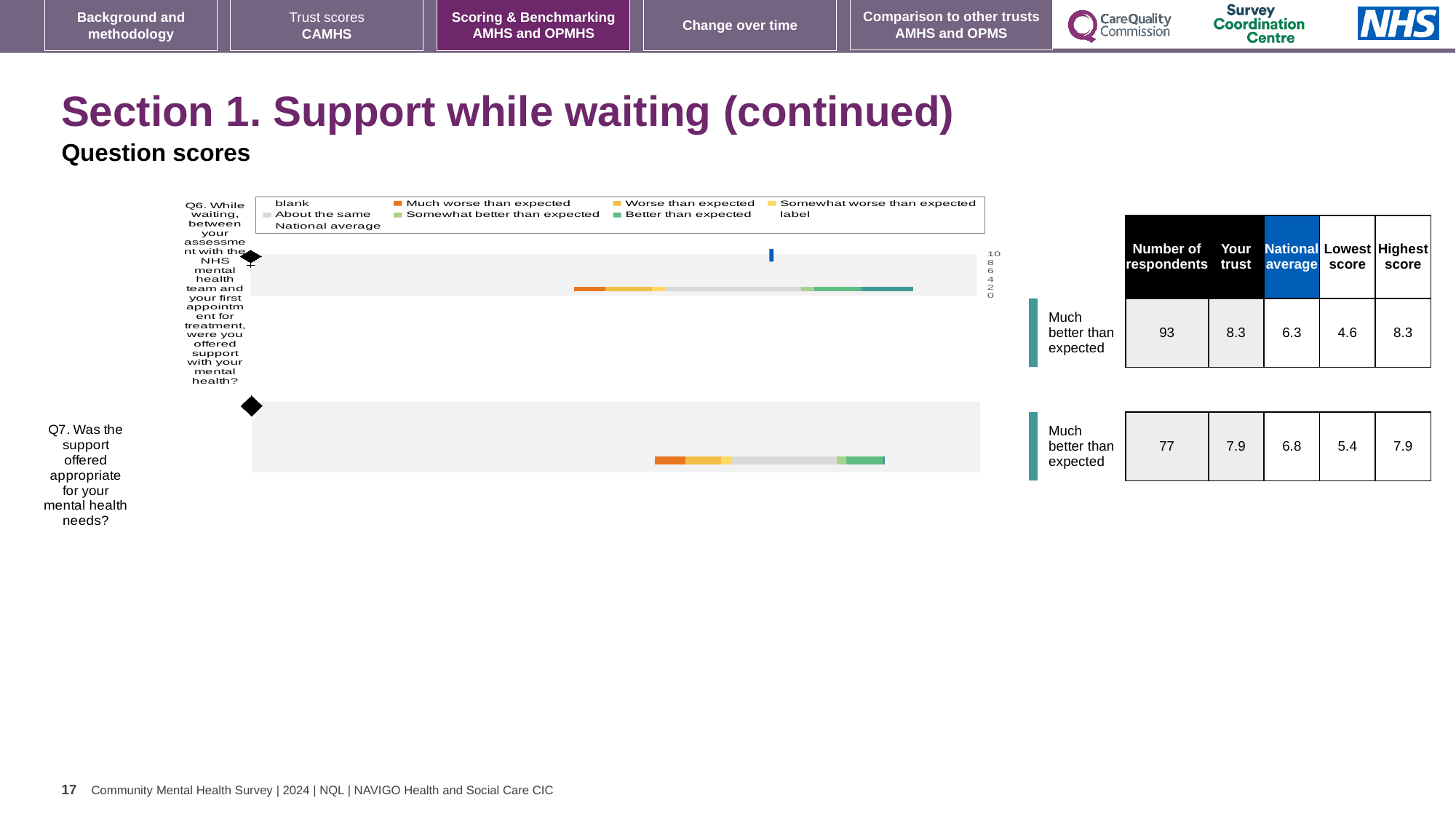
What is the difference between the 'Your trust' score and the national average for Q7? 1.1 How many questions (categories) are plotted in the chart? 2 How many respondents answered Q7? 77 What colour does the legend use for 'Much worse than expected'? orange Which question has the higher 'Your trust' score, Q6 or Q7? Q6 What kind of chart is used to show the question scores for Q6 and Q7? bar chart What is the 'Your trust' score for Q6? 8.3 Which legend entry is shown in light grey? About the same What benchmark rating is shown next to the chart for Q6? Much better than expected What is the 'Your trust' score for Q7? 7.9 What is the national average score for Q6? 6.3 What benchmark rating is shown next to the chart for Q7? Much better than expected